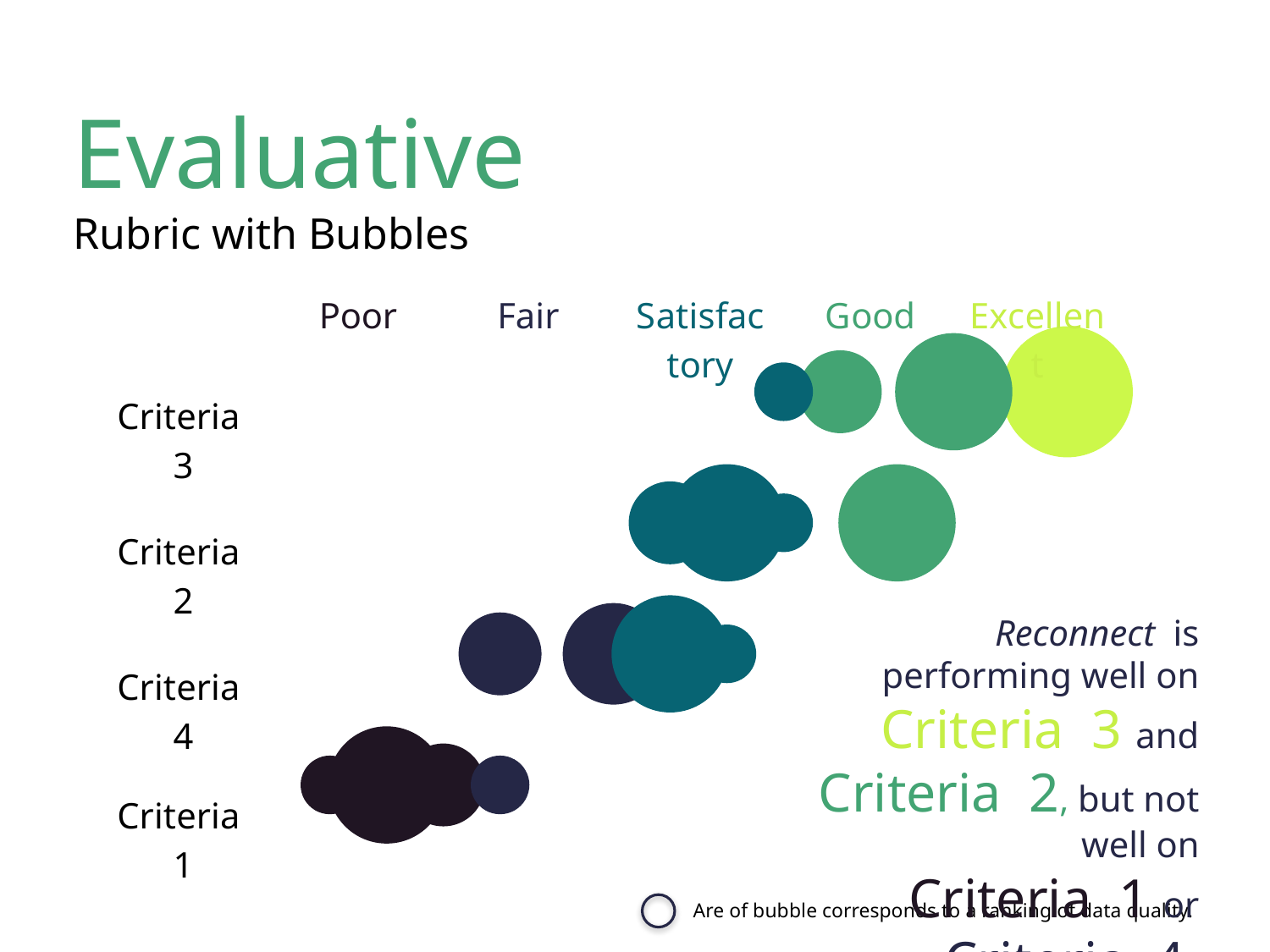
According to the note below the chart, what does the area of a bubble correspond to? a ranking of data quality What kind of chart is shown on the slide? bubble chart What is the main title of the slide? Evaluative Which criteria row is listed at the top of the chart? Criteria 3 Which criteria row is listed at the bottom of the chart? Criteria 1 How many criteria rows are plotted on the chart? 4 How many rating levels are shown across the top of the chart? 5 Which criteria has bubbles in the Poor column? Criteria 1 Which criteria has a bubble in the Excellent column? Criteria 3 Which criteria is rated higher on the rubric, Criteria 2 or Criteria 4? Criteria 2 Which criteria is rated higher on the rubric, Criteria 3 or Criteria 1? Criteria 3